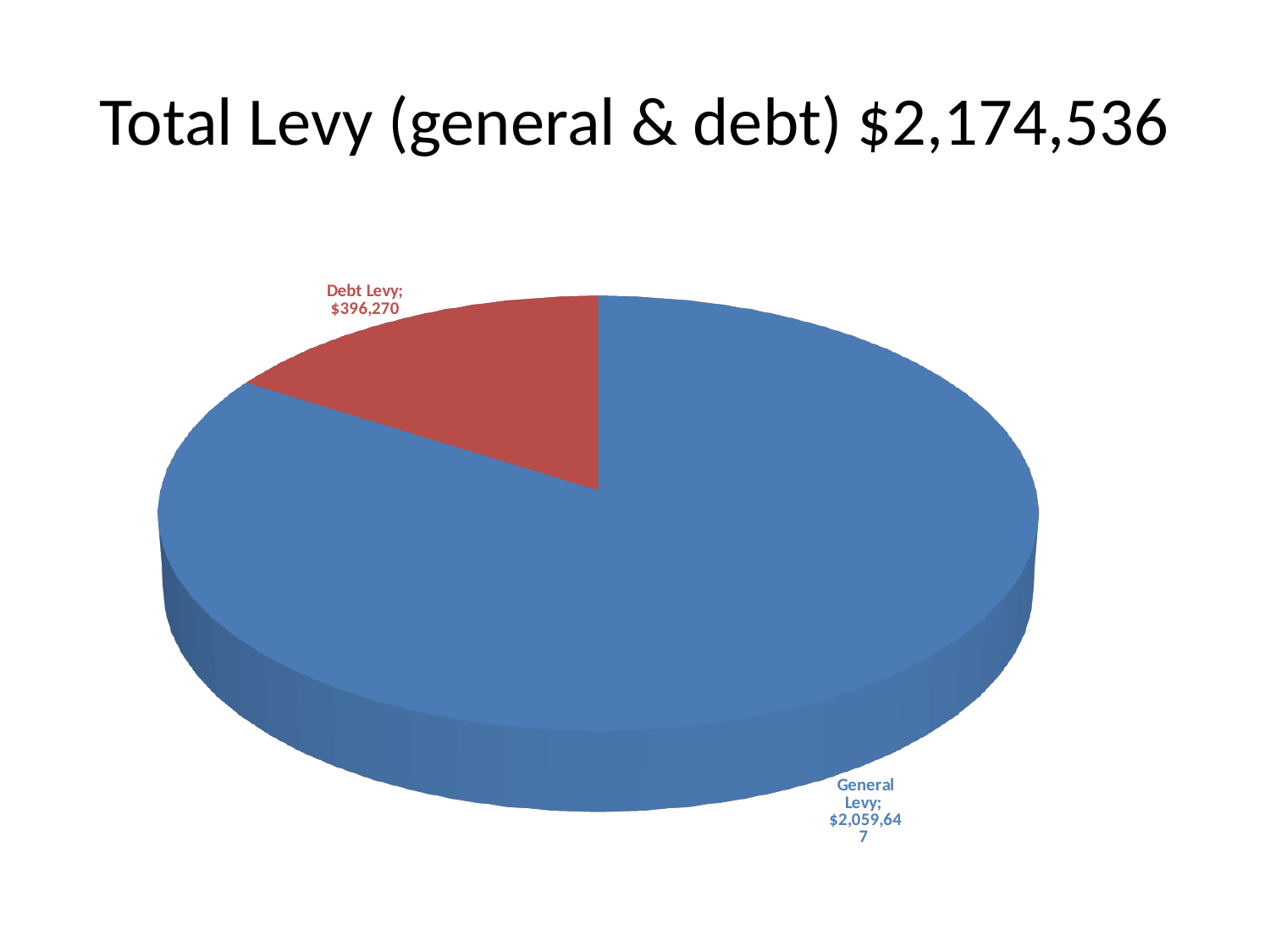
What colour is the Debt Levy slice? Red What is the difference between the General Levy and the Debt Levy values? $1,663,377 Which slice of the pie is the smallest? Debt Levy What kind of chart is shown on the slide? Pie chart What is the value of the Debt Levy slice? $396,270 Which slice of the pie is the largest? General Levy Which is larger, the General Levy or the Debt Levy? General Levy What is the value of the General Levy slice? $2,059,647 How many slices does the pie chart have? 2 What is the title of the slide? Total Levy (general & debt) $2,174,536